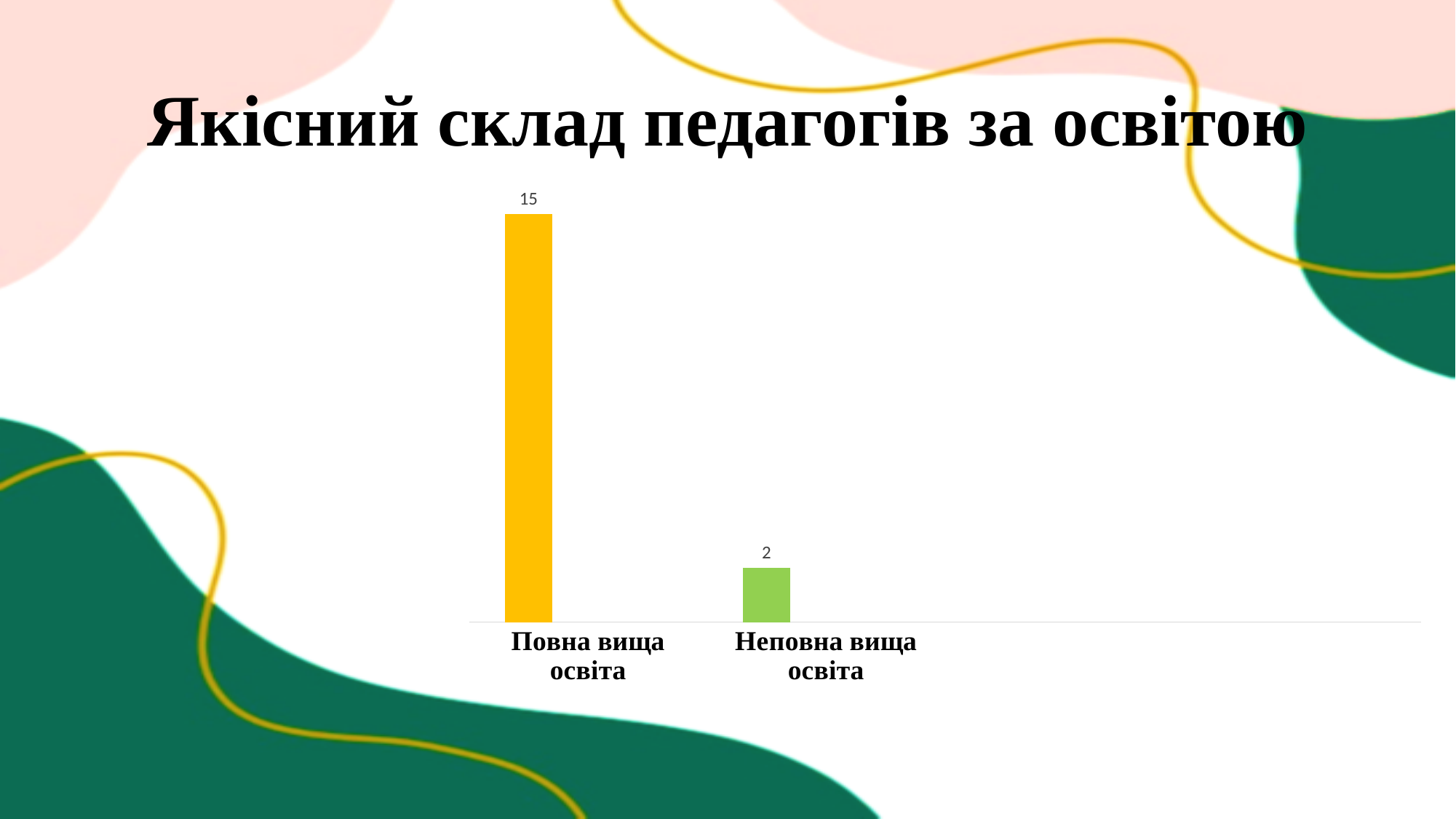
What is the value for Повна вища освіта? 15 What is the value for Неповна вища освіта? 2 How many categories are shown in the chart? 2 What is the difference between the values for Повна вища освіта and Неповна вища освіта? 13 Which category has the highest value? Повна вища освіта What kind of chart is shown on the slide? Bar chart What is the title of the slide? Якісний склад педагогів за освітою Which category has the lowest value? Неповна вища освіта What is the total of the two bars in the chart? 17 What colour is the bar for Повна вища освіта? Yellow Which is larger, the value for Повна вища освіта or the value for Неповна вища освіта? Повна вища освіта